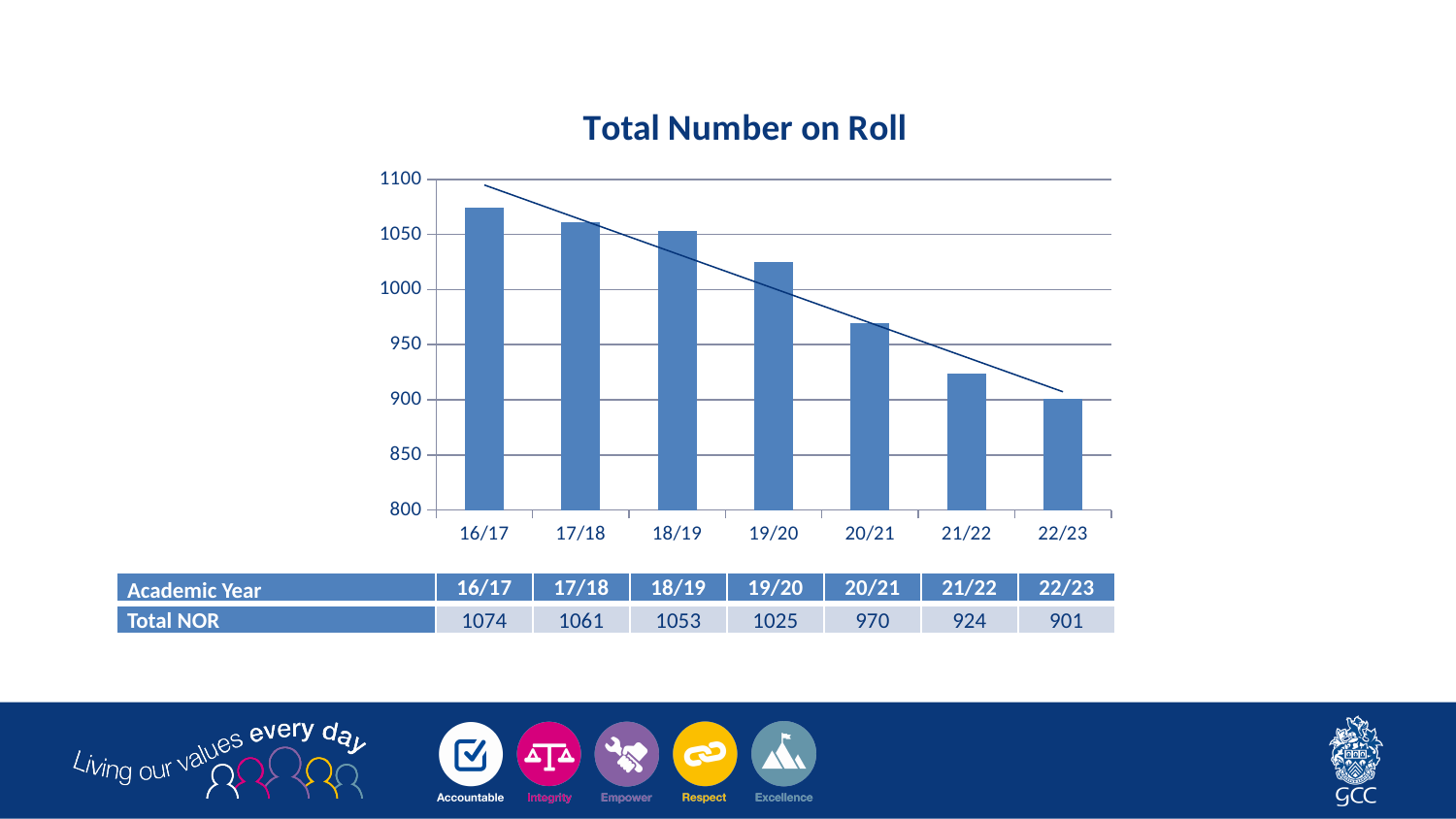
What is the Total NOR for 22/23? 901 What is the difference in Total NOR between 19/20 and 20/21? 55 Which academic year has the lowest Total NOR? 22/23 What kind of chart is shown on the slide? Bar chart How many academic years are shown on the chart? 7 Which academic year has the highest Total NOR? 16/17 Does the Total NOR rise or fall across the academic years from 16/17 to 22/23? Fall Which is larger, the Total NOR for 18/19 or for 21/22? 18/19 What is the Total NOR for 16/17? 1074 What is the difference in Total NOR between 16/17 and 22/23? 173 What is the title of the chart? Total Number on Roll What is the Total NOR for 20/21? 970